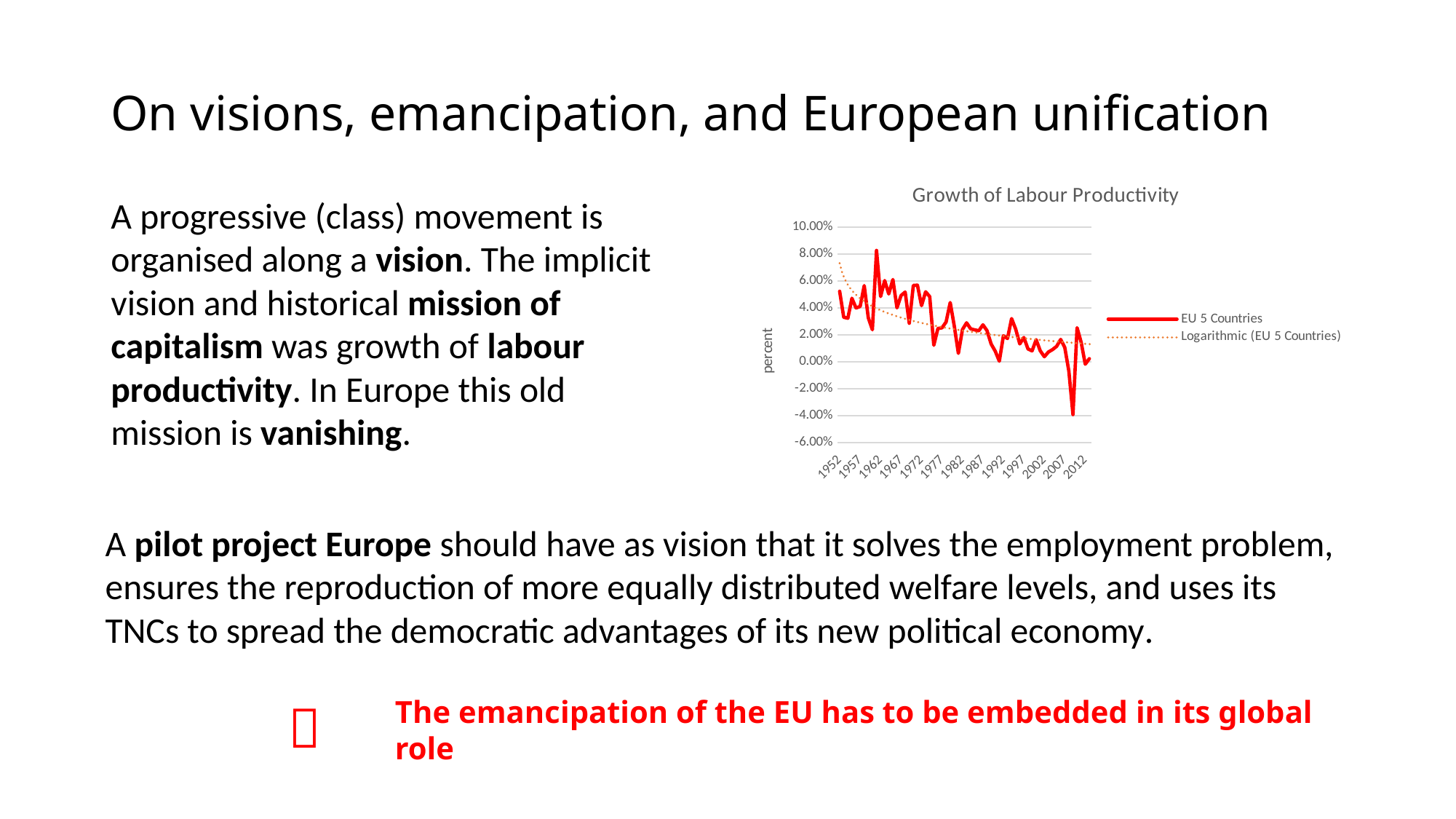
How many year labels are shown on the x axis of the chart? 13 What kind of chart is shown on the slide? line chart How many series does the chart's legend list? 2 What is the last year shown on the x axis of the chart? 2012 Does the Logarithmic (EU 5 Countries) trend line rise or fall across the years shown? fall What is the highest tick value shown on the vertical axis of the chart? 10.00% Is the lowest value of the EU 5 Countries line greater or less than -2.00%? less Does the EU 5 Countries line generally rise or fall from 1952 to 2012? fall Is the highest value of the EU 5 Countries line greater or less than 6.00%? greater Is the value of the EU 5 Countries line at 1952 greater or less than 0.00%? greater What label is shown on the vertical axis of the chart? percent What is the title of the chart on the slide? Growth of Labour Productivity